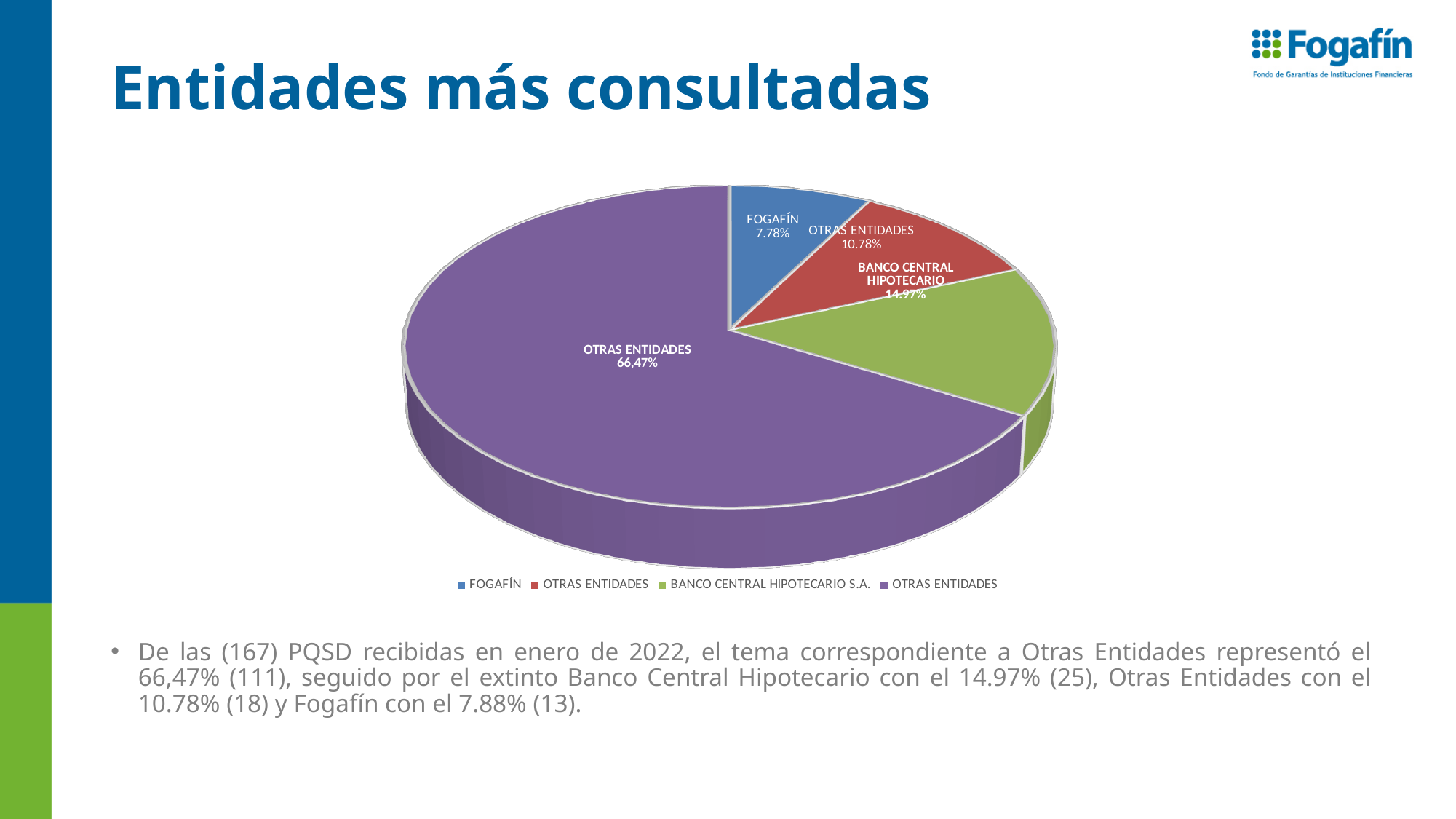
What kind of chart is shown on the slide? Pie chart What colour is the FOGAFÍN slice in the pie chart? Blue What percentage does the BANCO CENTRAL HIPOTECARIO slice show? 14.97% What percentage is printed on the large purple OTRAS ENTIDADES slice? 66,47% What percentage is printed on the red OTRAS ENTIDADES slice? 10.78% What percentage does the FOGAFÍN slice show? 7.78% What is the difference in percentage points between the BANCO CENTRAL HIPOTECARIO slice and the FOGAFÍN slice? 7.19% How many entries does the legend of the pie chart list? 4 Which slice is larger, FOGAFÍN or BANCO CENTRAL HIPOTECARIO? BANCO CENTRAL HIPOTECARIO Which slice of the pie chart is the smallest? FOGAFÍN Which slice of the pie chart is the largest? OTRAS ENTIDADES (purple, 66,47%) How many slices does the pie chart have? 4